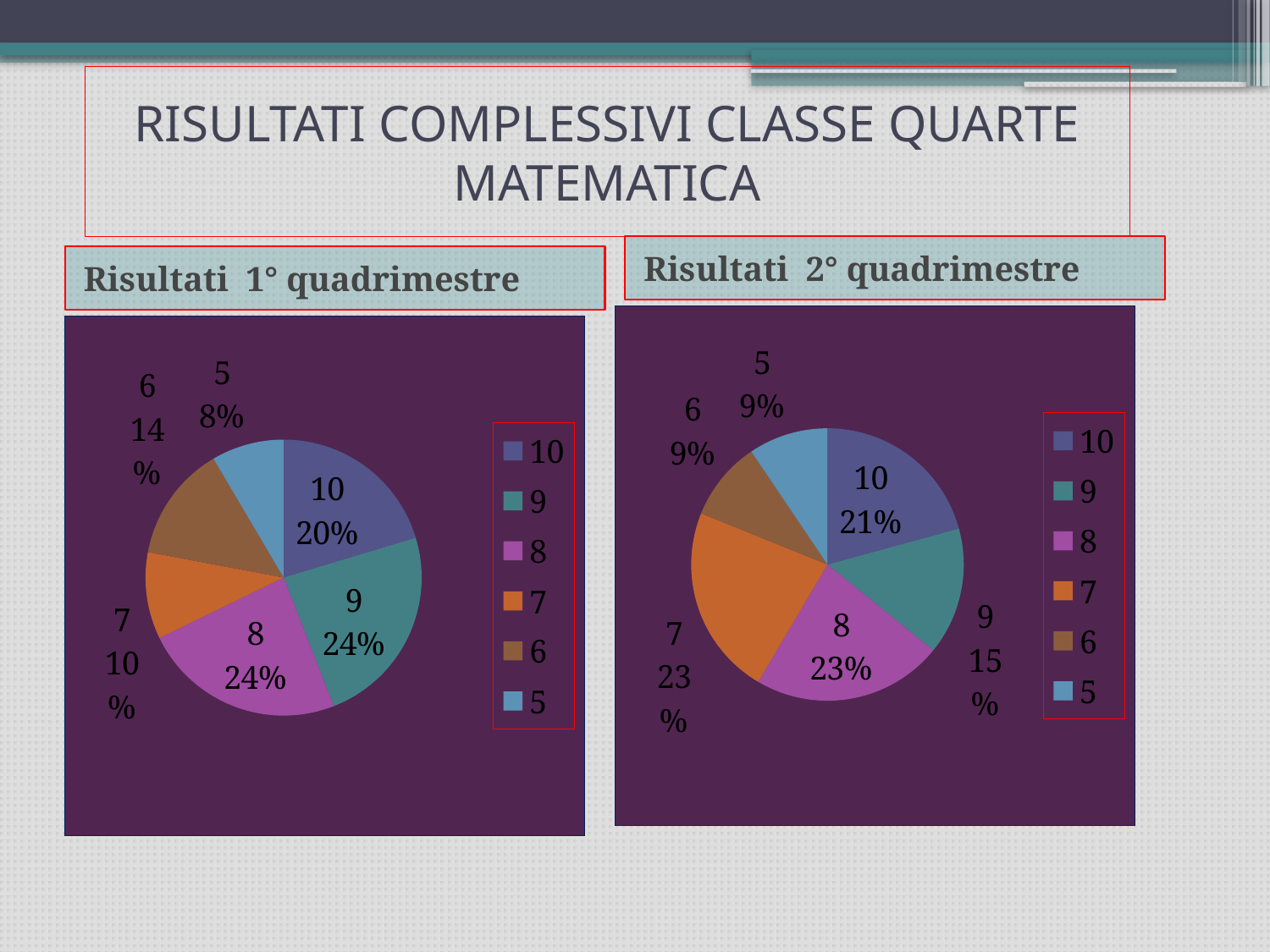
How many entries does the legend of the 'Risultati 1° quadrimestre' chart list? 6 In the 'Risultati 1° quadrimestre' chart, what share of the pie does grade 6 have? 14% In the 'Risultati 1° quadrimestre' chart, what is the difference between the shares for grade 9 and grade 7? 14% What kind of chart is used for 'Risultati 1° quadrimestre'? Pie chart In the 'Risultati 2° quadrimestre' chart, what share of the pie does grade 7 have? 23% In the 'Risultati 1° quadrimestre' chart, which is larger, the share for grade 8 or the share for grade 5? 8 In the 'Risultati 2° quadrimestre' chart, what share of the pie does grade 9 have? 15% How many slices does the 'Risultati 2° quadrimestre' chart have? 6 In the 'Risultati 1° quadrimestre' chart, which grade has the smallest slice? 5 In the 'Risultati 2° quadrimestre' chart, which is larger, the share for grade 10 or the share for grade 9? 10 In the 'Risultati 2° quadrimestre' chart, what is the difference between the shares for grade 8 and grade 6? 14% In the 'Risultati 1° quadrimestre' chart, what share of the pie does grade 10 have? 20%